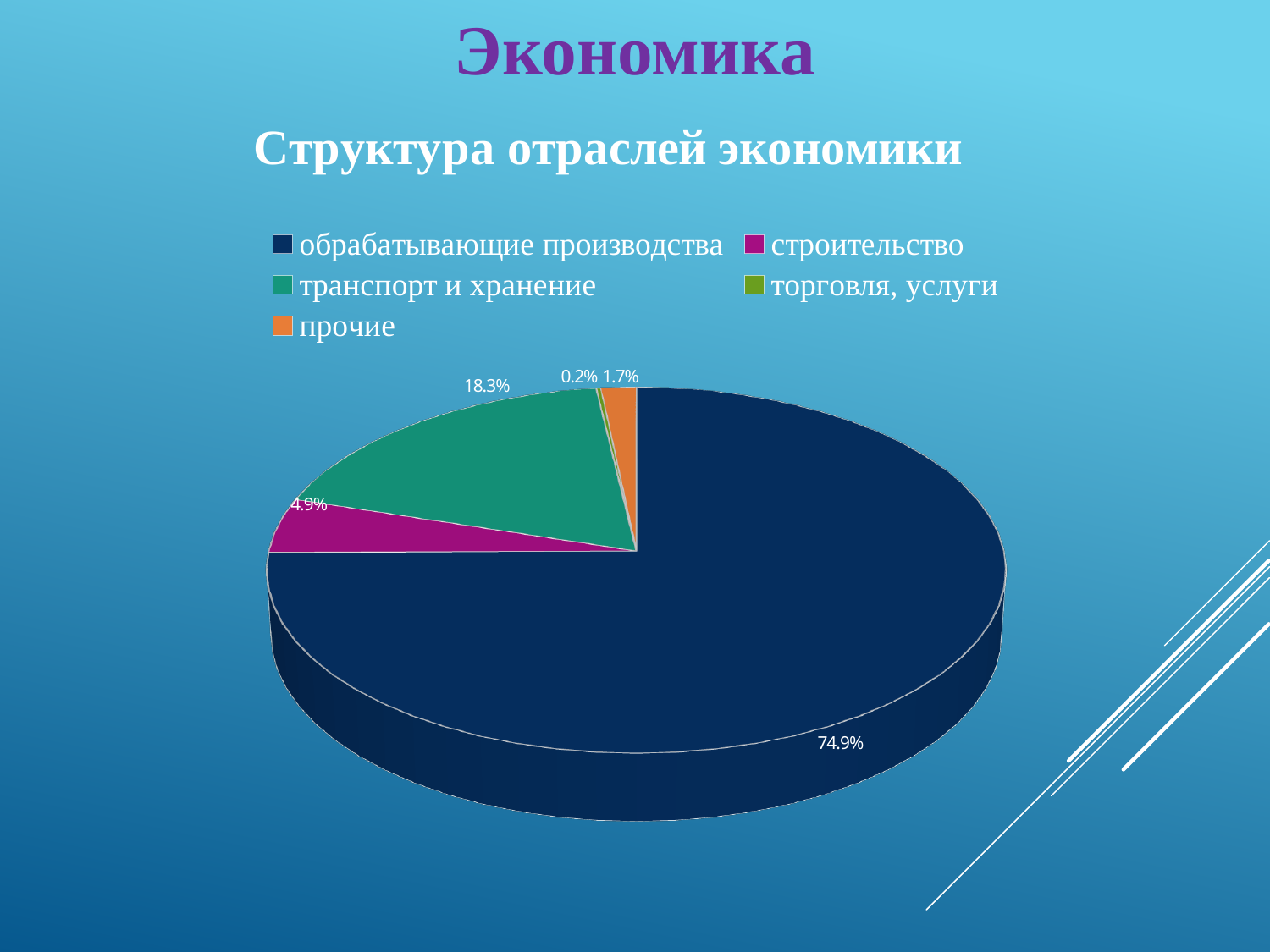
How many categories does the legend list? 5 What share of the pie is прочие? 1.7% What is the difference between the shares for обрабатывающие производства and транспорт и хранение? 56.6% What is the title of the chart? Структура отраслей экономики What share of the pie is торговля, услуги? 0.2% Which is larger, the share for транспорт и хранение or the share for строительство? транспорт и хранение What kind of chart is shown on the slide? pie chart What share of the pie is обрабатывающие производства? 74.9% What share of the pie is транспорт и хранение? 18.3% What share of the pie is строительство? 4.9% Which category has the smallest share of the pie? торговля, услуги Which category has the largest share of the pie? обрабатывающие производства